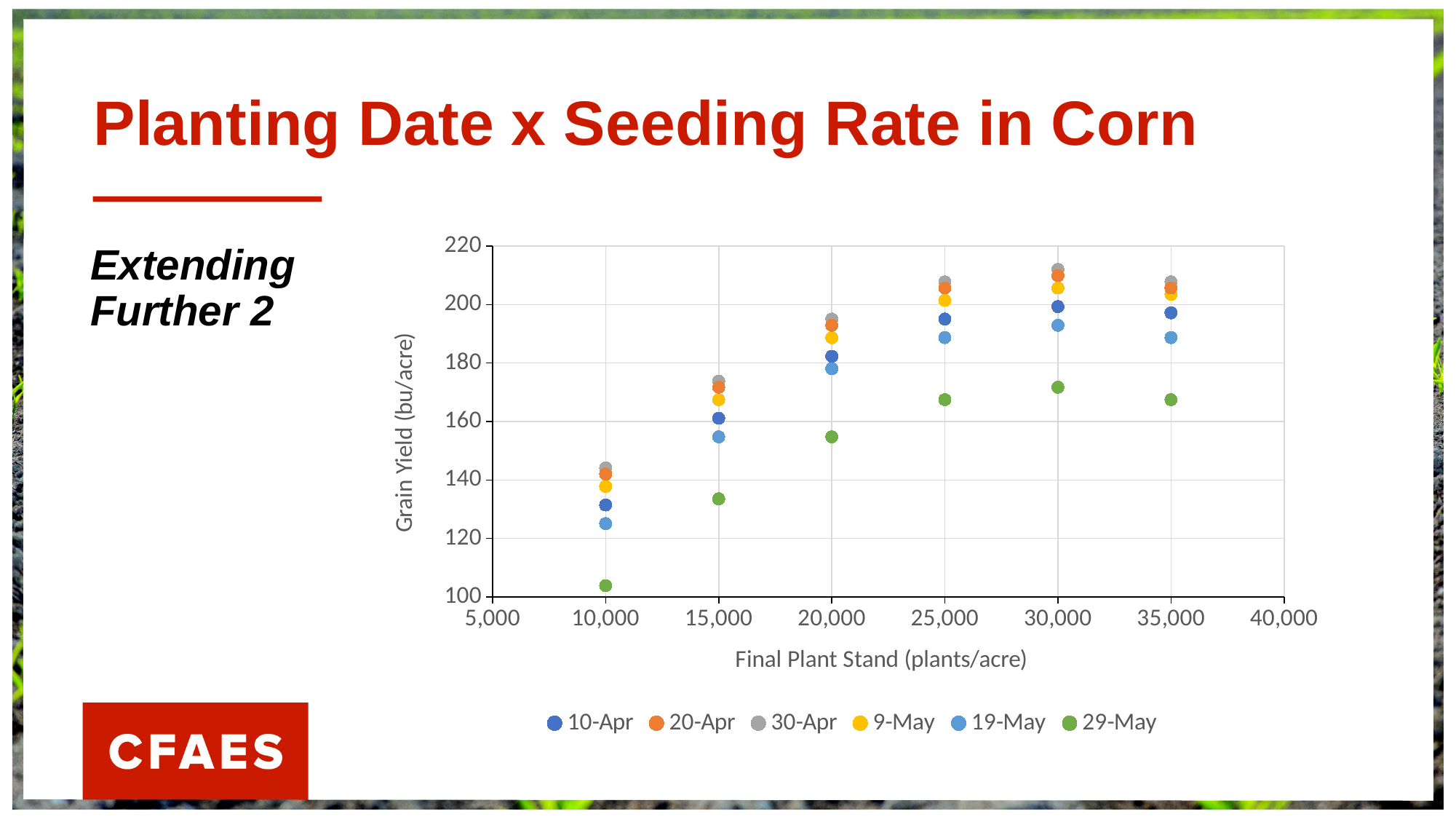
Is the grain yield for 10-Apr at 25,000 plants/acre greater or less than 180? greater How many series does the chart legend list? 6 Is the grain yield for 30-Apr at 30,000 plants/acre greater or less than 200? greater What kind of chart is shown on the slide? Scatter chart Which planting date has the lowest grain yield at a final plant stand of 30,000 plants/acre? 29-May At 20,000 plants/acre, which has the higher grain yield: 10-Apr or 19-May? 10-Apr Does the grain yield for 29-May rise or fall as the final plant stand increases from 10,000 to 25,000 plants/acre? rise Is the grain yield for 29-May at 10,000 plants/acre greater or less than 120? less How many final plant stand levels have points plotted on the chart? 6 Which planting date has the lowest grain yield at a final plant stand of 10,000 plants/acre? 29-May What is the title of the chart's x axis? Final Plant Stand (plants/acre)